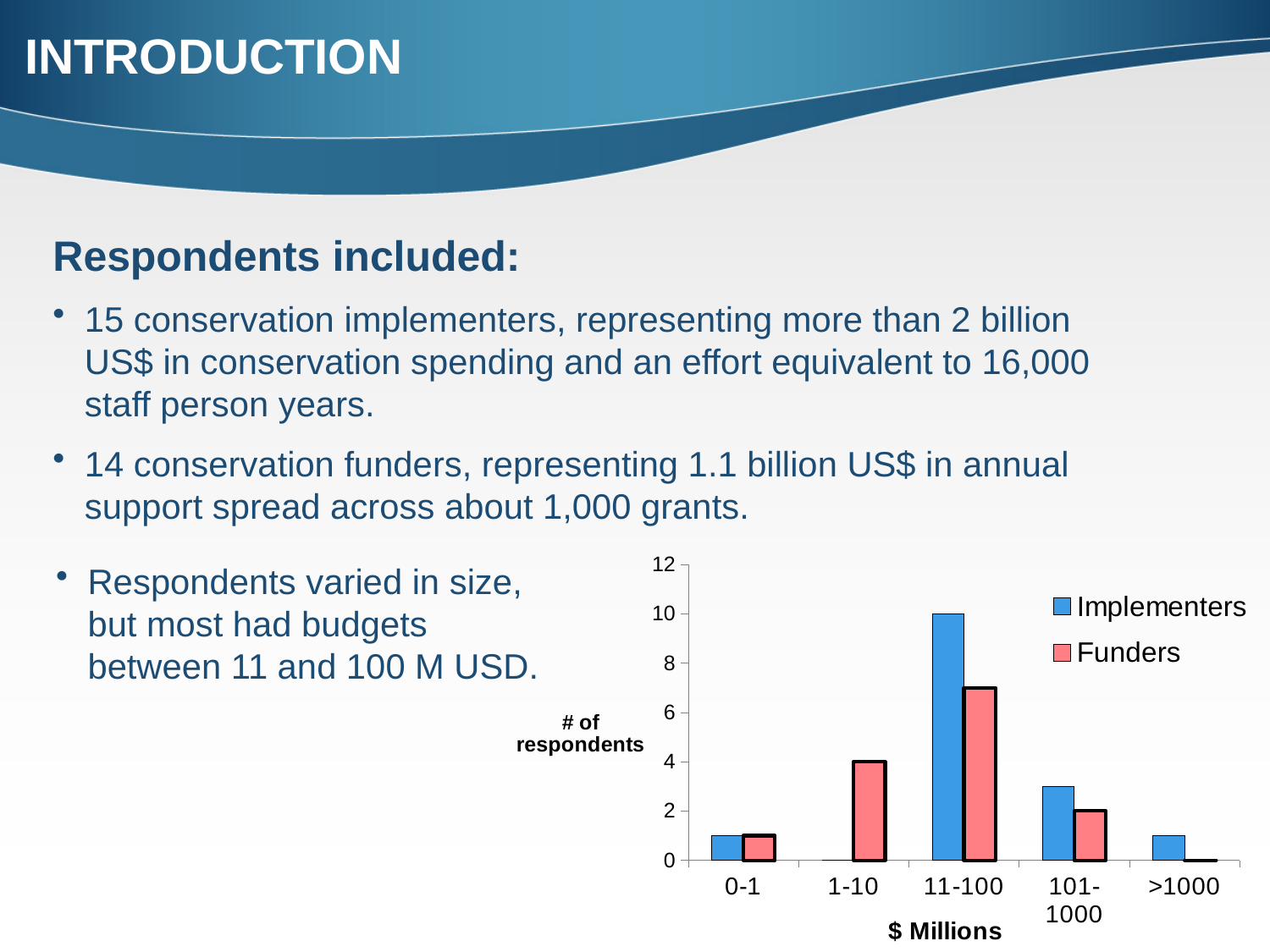
What is the label of the x axis of the chart? $ Millions Is the number of Implementers respondents in the 101-1000 category greater or less than 4? less What kind of chart is shown on the slide? bar chart In the 1-10 $ Millions category, which series has more respondents, Implementers or Funders? Funders Is the number of Funders respondents in the 11-100 category greater or less than 6? greater Which $ Millions category has the highest number of Funders respondents? 11-100 What is the number of Implementers respondents in the 11-100 $ Millions category? 10 What is the number of Funders respondents in the 1-10 $ Millions category? 4 How many series does the chart legend list? 2 Which $ Millions category has the highest number of Implementers respondents? 11-100 How many budget categories are shown on the x axis of the chart? 5 What is the number of Funders respondents in the 101-1000 $ Millions category? 2